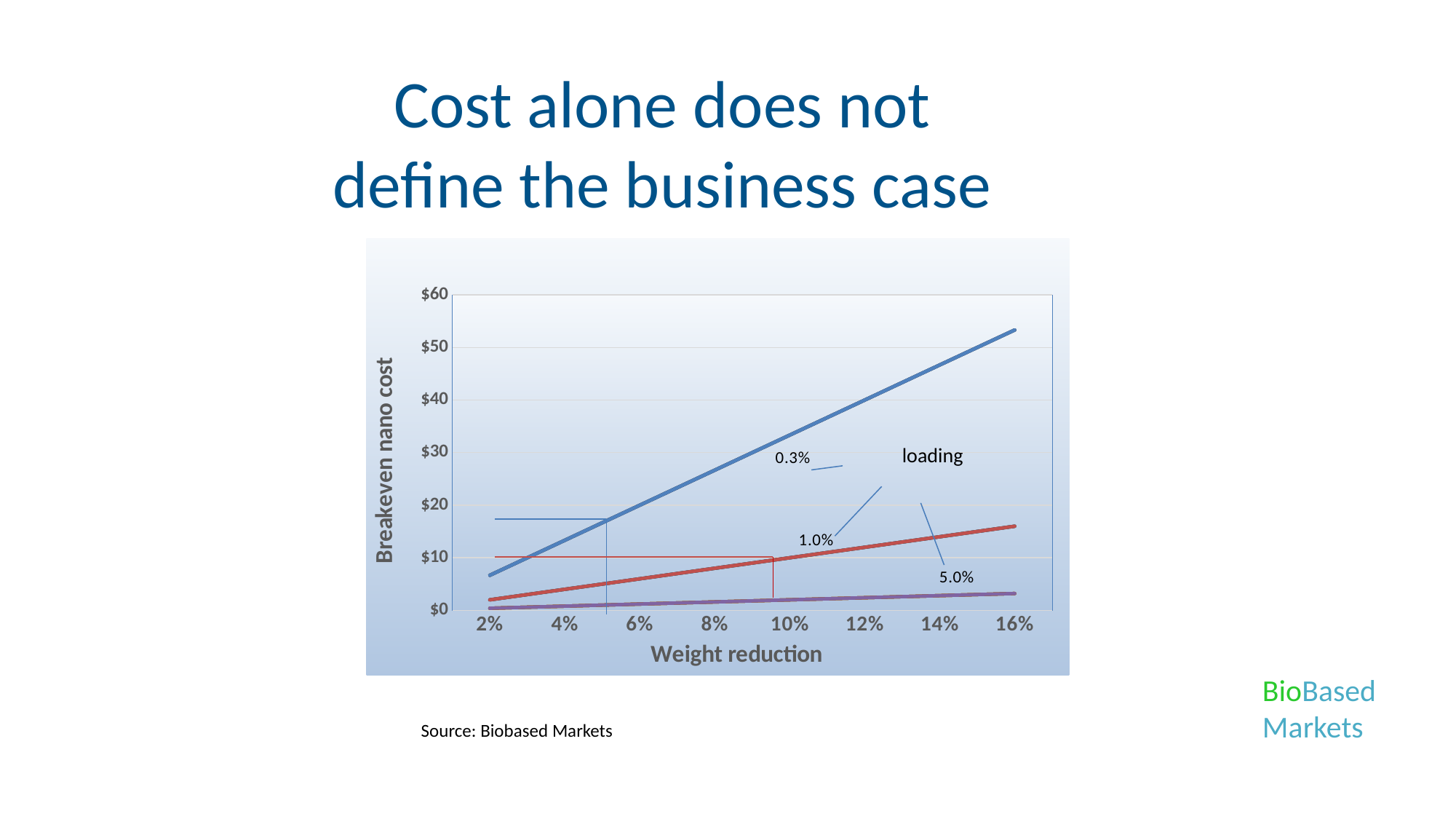
What kind of chart is shown on the slide? line chart Is the breakeven nano cost for the 0.3% loading line at 2% weight reduction greater or less than $10? less How many loading lines are plotted on the chart? 3 At 16% weight reduction, which loading line has the higher breakeven nano cost, 0.3% or 1.0%? 0.3% Is the breakeven nano cost for the 5.0% loading line at 16% weight reduction greater or less than $10? less What is the title of the x axis of the chart? Weight reduction Is the breakeven nano cost for the 0.3% loading line at 16% weight reduction greater or less than $50? greater Which loading line has the lowest breakeven nano cost at 16% weight reduction? 5.0% What is the title of the y axis of the chart? Breakeven nano cost Does the breakeven nano cost for the 0.3% loading line rise or fall as weight reduction increases? rise